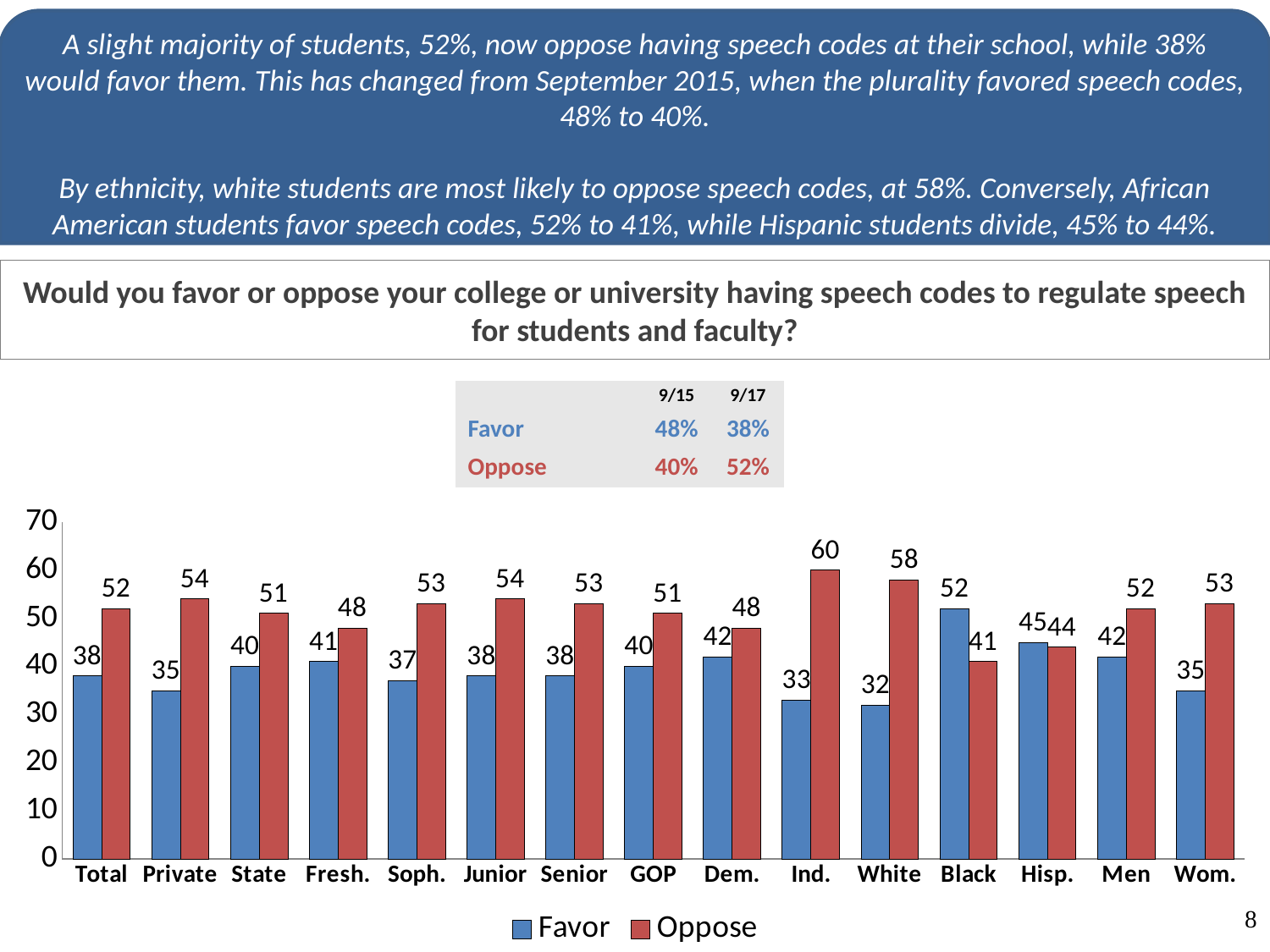
How many series does the legend list? 2 What is the Oppose value for White? 58 What is the Favor value for Total? 38 What is the Oppose value for Ind.? 60 What are the two series listed in the legend? Favor and Oppose How many categories are shown on the x axis? 15 Which category has the highest Oppose value? Ind. What kind of chart is shown? Bar chart Which category has the lowest Favor value? White Which category has the highest Favor value? Black What is the difference between the Oppose and Favor values for Total? 14 For Black, which is larger, Favor or Oppose? Favor